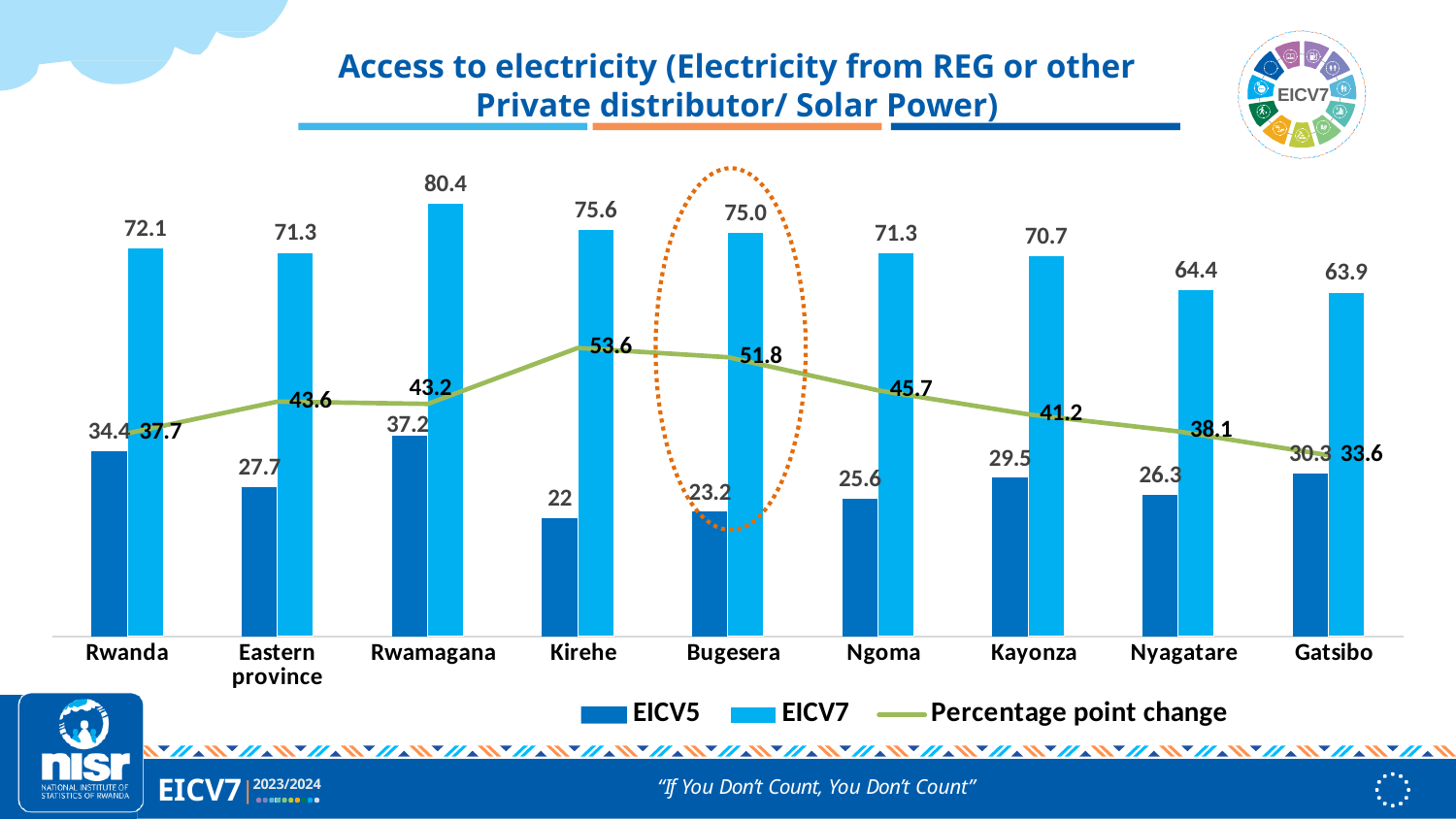
Which category has the highest percentage point change? Kirehe Which category has the lowest EICV7 value? Gatsibo What is the EICV5 value for Kayonza? 29.5 What is the EICV5 value for Kirehe? 22 Which category is highlighted with a dotted orange circle? Bugesera What is the difference between the EICV7 and EICV5 values for Rwanda? 37.7 Which category has the highest EICV7 value? Rwamagana How many series does the legend list? 3 What is the percentage point change for Bugesera? 51.8 Which has the larger EICV7 value, Nyagatare or Gatsibo? Nyagatare What is the EICV7 value for Rwamagana? 80.4 How many categories are shown on the x axis? 9